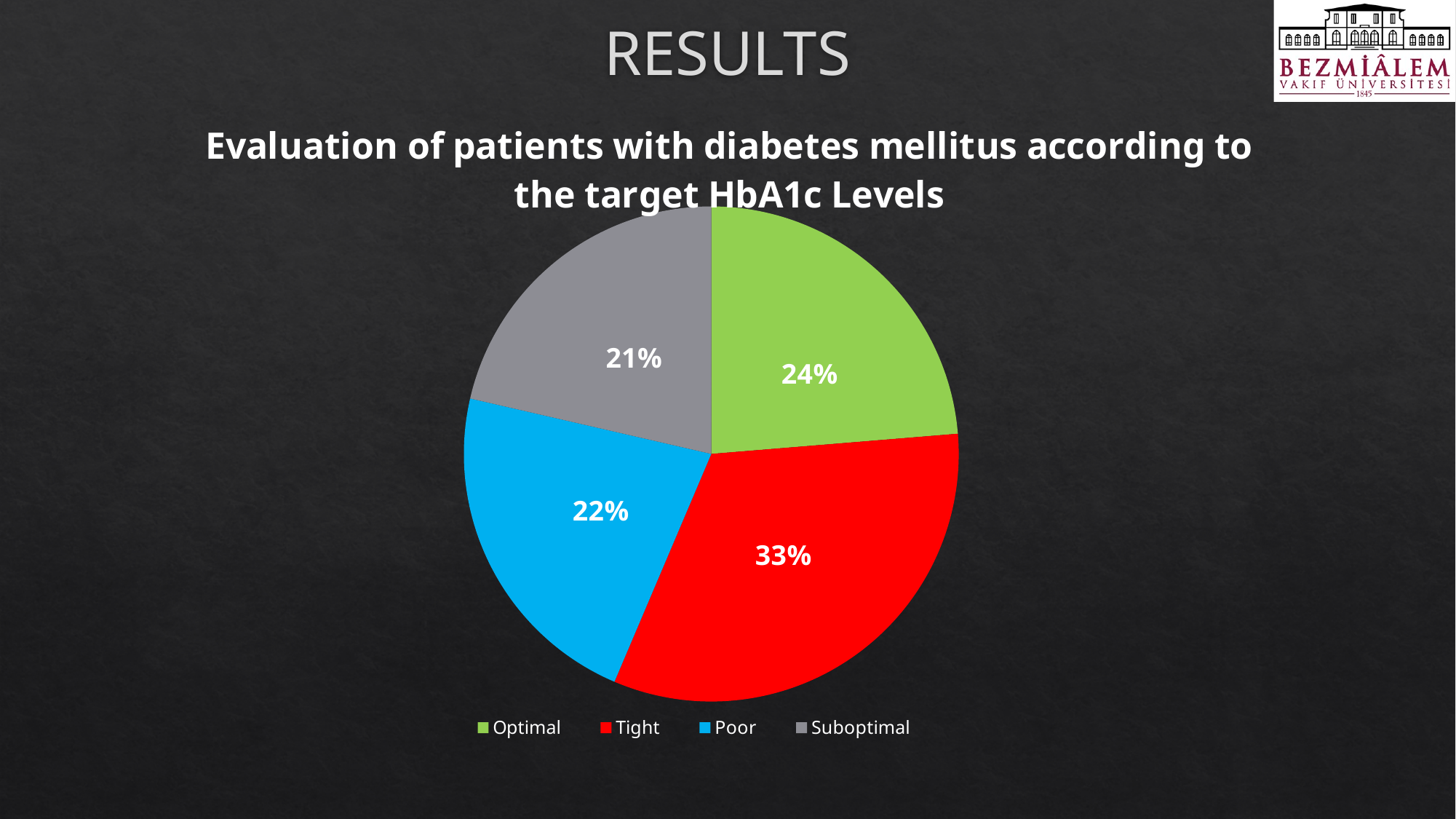
What percentage of patients are in the Suboptimal category? 21% Which category has the smallest share of the pie? Suboptimal Which category has a larger share, Optimal or Poor? Optimal What kind of chart is shown on the slide? pie chart How many categories does the pie chart show? 4 What percentage of patients are in the Poor category? 22% What percentage of patients are in the Optimal category? 24% What is the difference in percentage points between the Tight and Optimal categories? 9 What colour is the Poor slice of the pie? blue What is the title of the chart? Evaluation of patients with diabetes mellitus according to the target HbA1c Levels Which category has the largest share of the pie? Tight What percentage of patients are in the Tight category? 33%